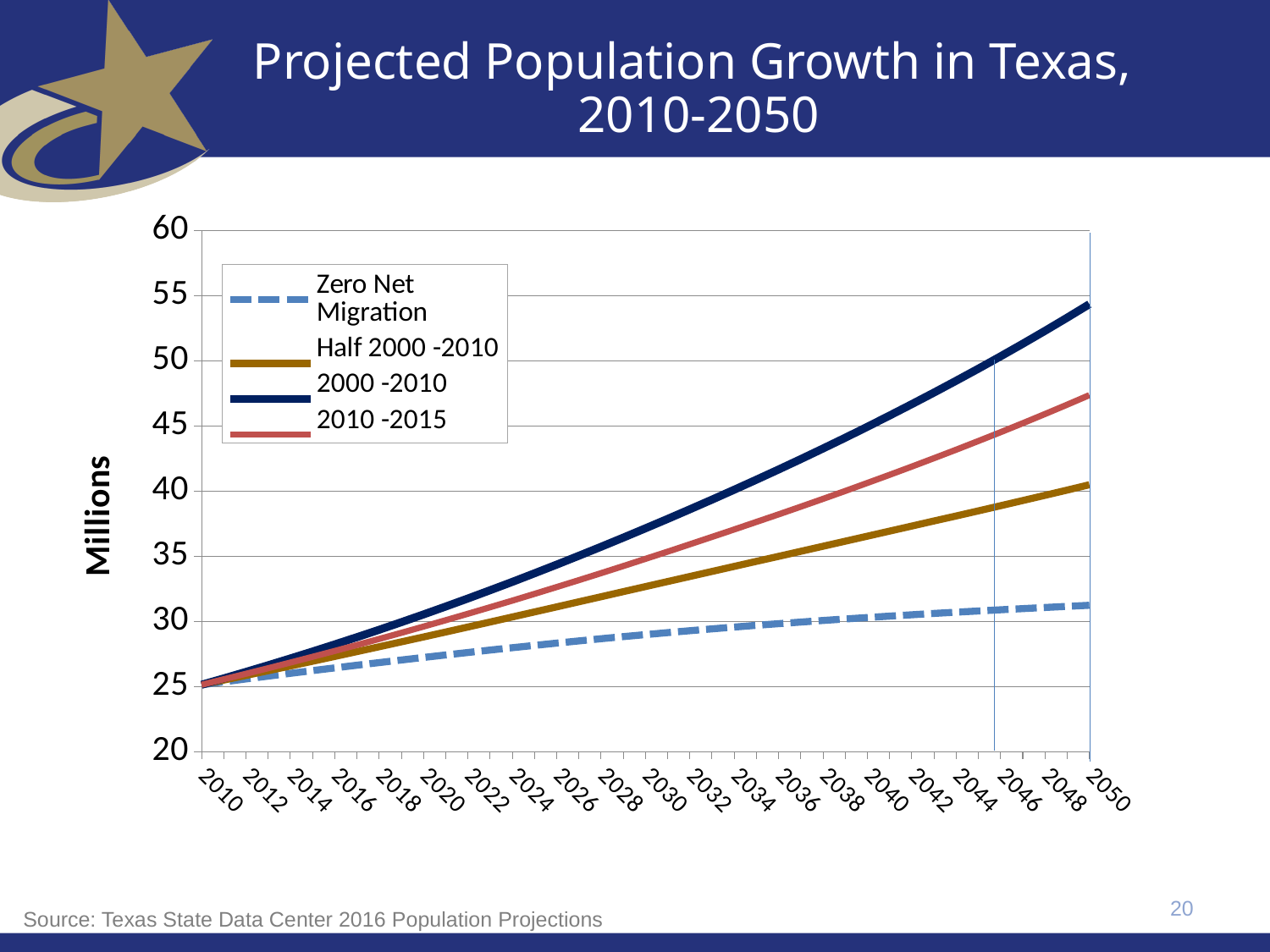
Which series has the lowest projected population in 2050? Zero Net Migration In 2050, which is larger: the 2010 -2015 series or the Half 2000 -2010 series? 2010 -2015 Is the value for the Half 2000 -2010 series in 2050 greater or less than 45? less Is the value for the 2000 -2010 series in 2050 greater or less than 50? greater Which series is drawn with a dashed line? Zero Net Migration What kind of chart is shown on the slide? line chart How many series does the legend list? 4 Is the value for the Zero Net Migration series in 2050 greater or less than 35? less Which series has the highest projected population in 2050? 2000 -2010 Does the 2000 -2010 series rise or fall from 2010 to 2050? rise What is the label on the vertical axis of the chart? Millions